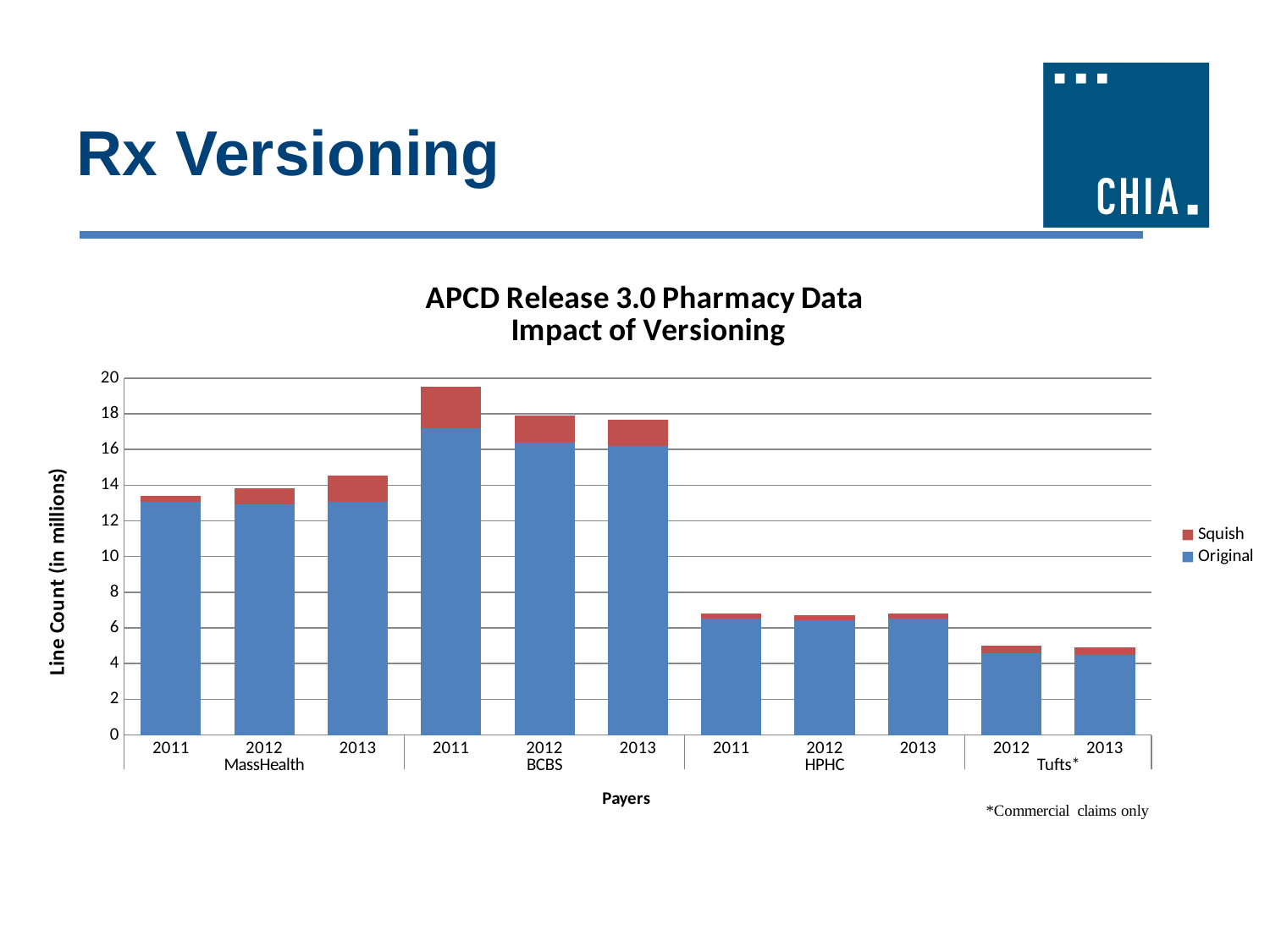
What is the label on the vertical axis of the chart? Line Count (in millions) Do the MassHealth bars rise or fall from 2011 to 2013? rise Do the BCBS bars rise or fall from 2011 to 2013? fall How many bars are plotted in the chart? 11 Is the total bar for BCBS 2011 greater or less than 18? greater Which payer group has the shortest bars overall? Tufts* Is the total bar for Tufts* 2012 greater or less than 6? less How many series does the legend list? 2 Which payer and year has the tallest bar? BCBS 2011 Which is larger, the 2013 bar for MassHealth or the 2013 bar for BCBS? BCBS What kind of chart is shown on the slide? Stacked bar chart Is the total bar for MassHealth 2011 greater or less than 14? less